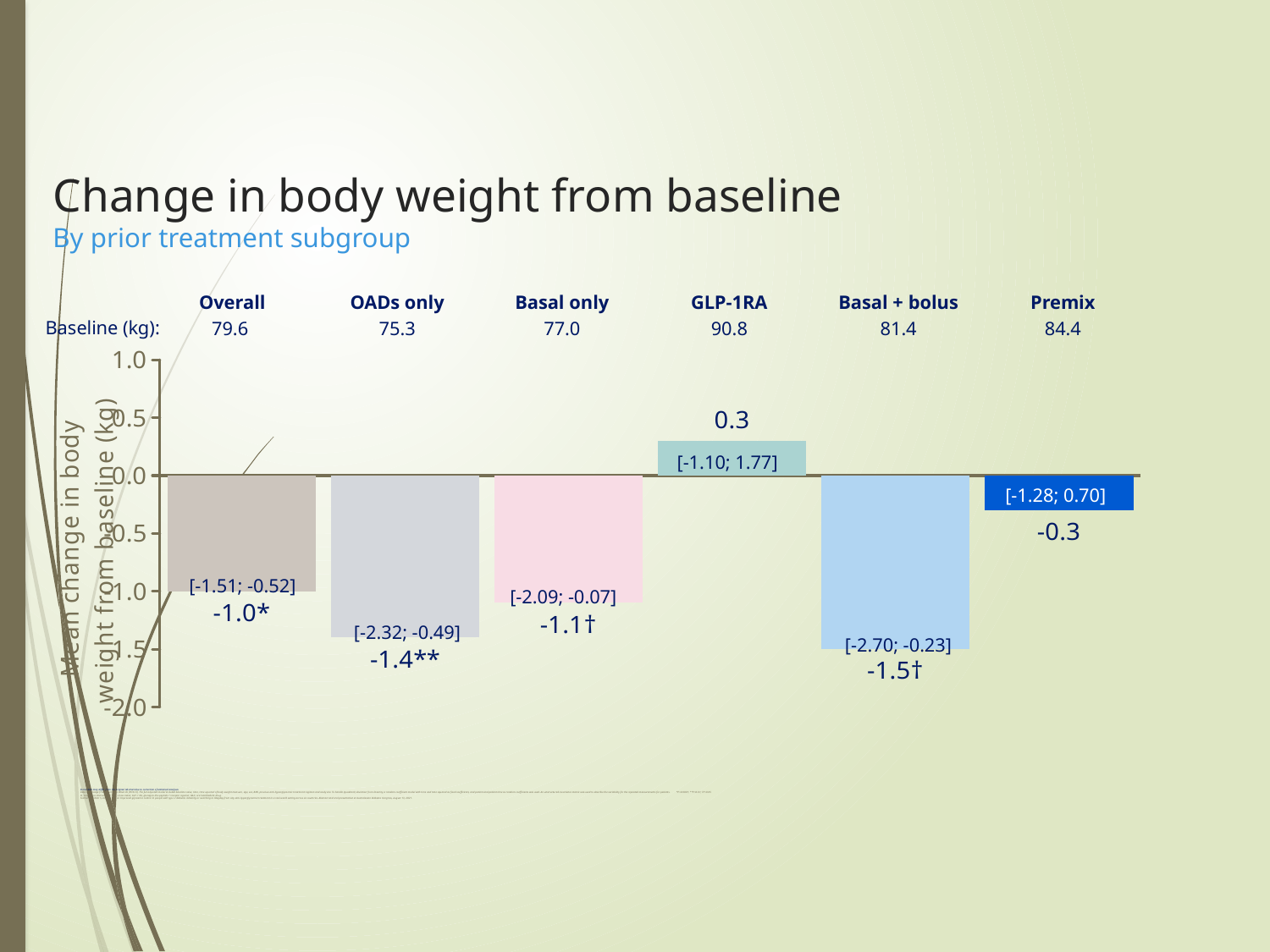
What type of chart is shown on the slide? bar chart What is the difference between the mean change for OADs only (-1.4) and Overall (-1.0)? 0.4 Which subgroup shows the largest decrease in body weight from baseline? Basal + bolus Which subgroup has a larger decrease in body weight, Basal only or Premix? Basal only What is the mean change in body weight from baseline for the GLP-1RA subgroup? 0.3 What is the mean change in body weight from baseline for the Basal + bolus subgroup? -1.5 What is the subtitle of the chart slide? By prior treatment subgroup What is the baseline body weight (kg) shown for the GLP-1RA subgroup? 90.8 What is the mean change in body weight from baseline for the Premix subgroup? -0.3 Which subgroup is the only one with a positive mean change in body weight? GLP-1RA How many prior treatment subgroups (categories) are plotted in the chart? 6 What is the confidence interval printed for the OADs only subgroup? [-2.32; -0.49]